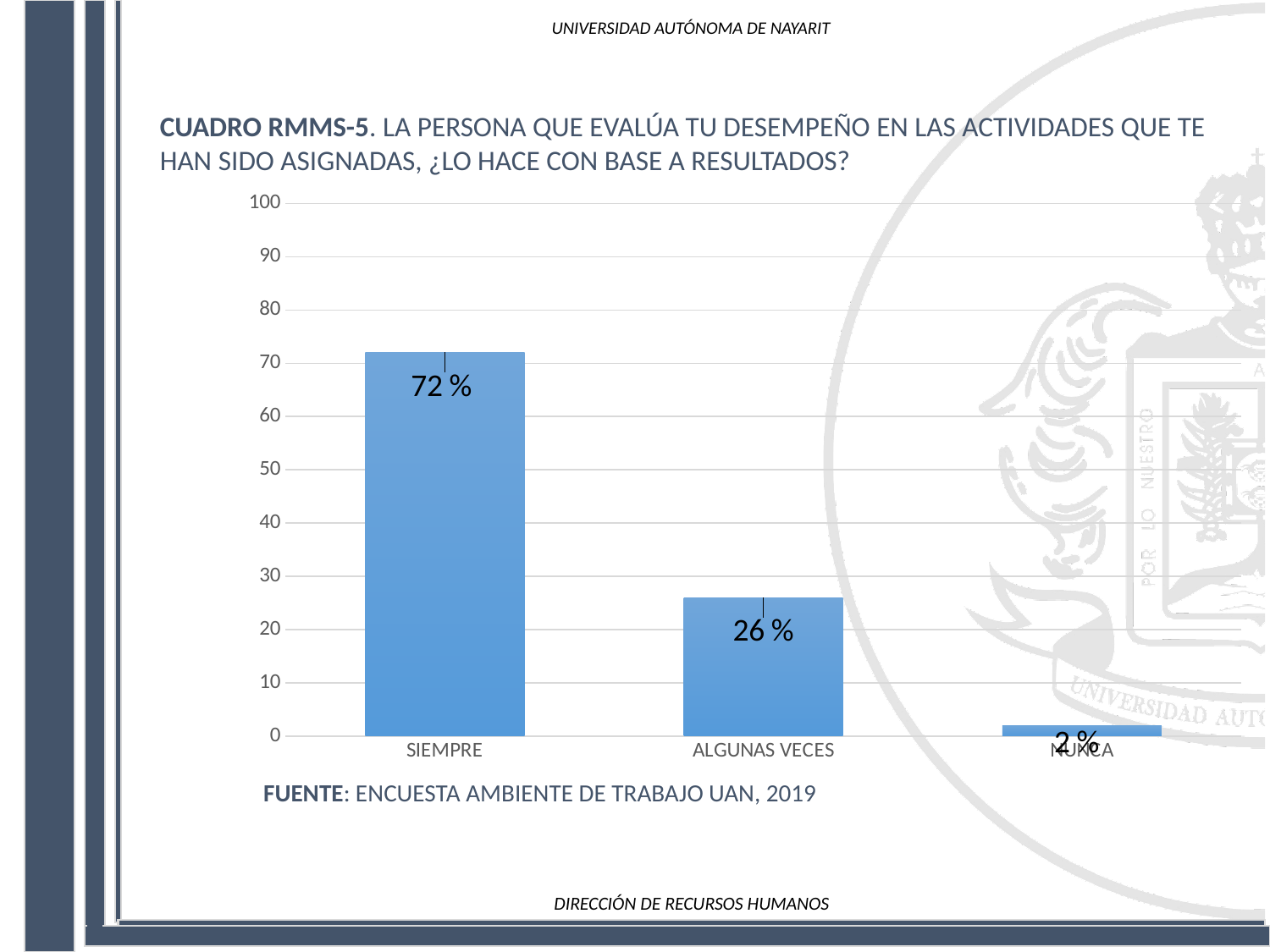
What is the value for SIEMPRE? 72 % Which is larger, the value for ALGUNAS VECES or the value for NUNCA? ALGUNAS VECES Which category has the lowest value? NUNCA How many categories are shown on the x axis? 3 What is the value for NUNCA? 2 % What kind of chart is shown on the slide? bar chart Which category has the highest value? SIEMPRE What is the value for ALGUNAS VECES? 26 % What is the difference between the values for ALGUNAS VECES and NUNCA? 24 % What source is cited below the chart? ENCUESTA AMBIENTE DE TRABAJO UAN, 2019 What is the difference between the values for SIEMPRE and ALGUNAS VECES? 46 % Is the value for SIEMPRE greater or less than 50? greater